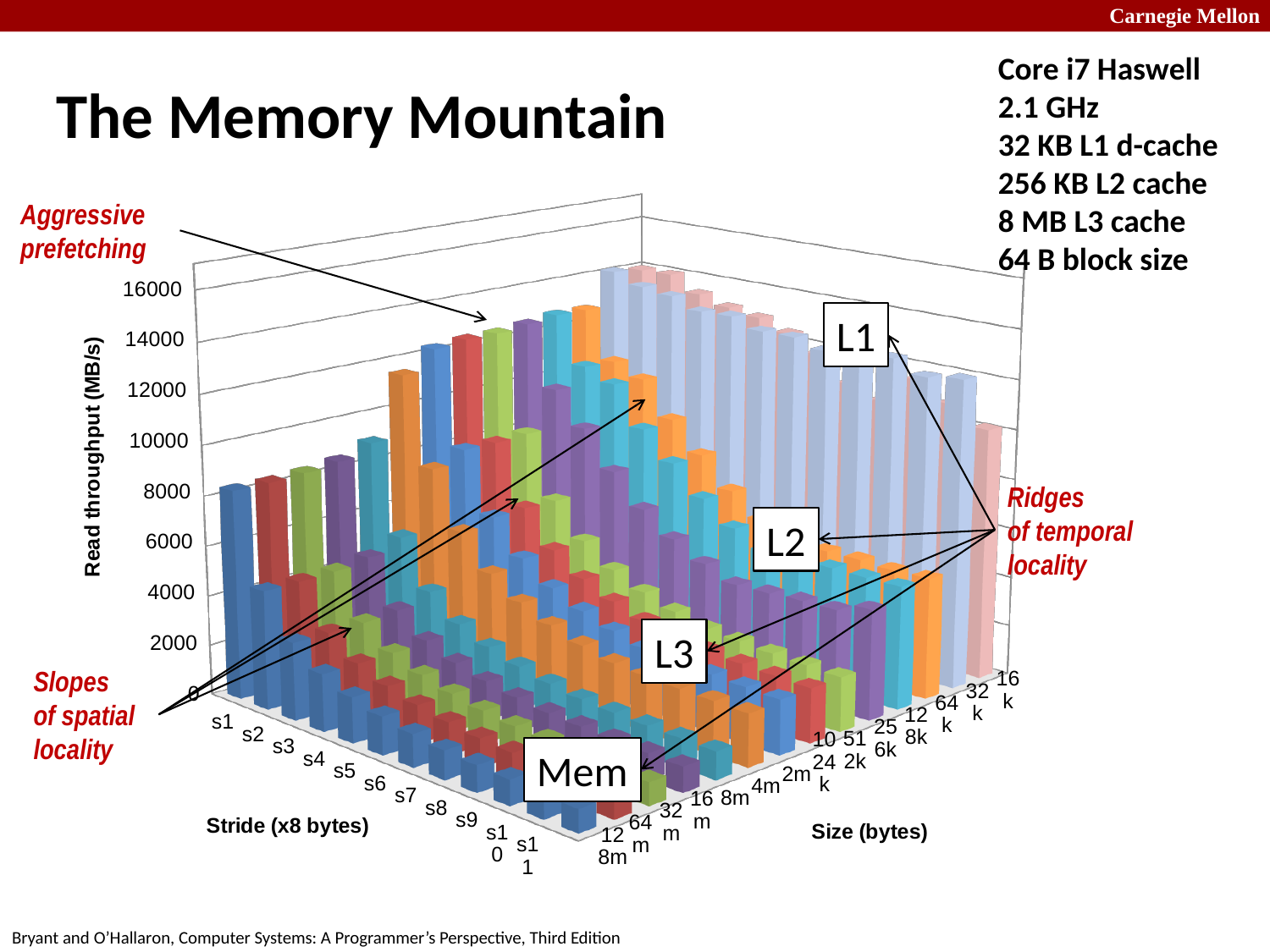
Is the read throughput for stride s1 at size 128m greater or less than 4000? greater How many size categories are shown on the Size (bytes) axis? 14 How many stride categories are shown on the Stride (x8 bytes) axis? 11 Which is larger: the read throughput for stride s1 at size 16k or for stride s1 at size 128m? stride s1 at size 16k What kind of chart is shown on the slide? bar chart For a fixed size, does read throughput rise or fall as the stride increases from s1 to s11? fall What is the title of the vertical axis? Read throughput (MB/s) Is the read throughput for stride s11 at size 128m greater or less than 4000? less Which four memory levels are labelled on the chart? L1, L2, L3, Mem For stride s1, does read throughput rise or fall as the size increases from 16k to 128m? fall Which stride has the highest read throughput? s1 Is the read throughput for stride s1 at size 16k greater or less than 12000? greater